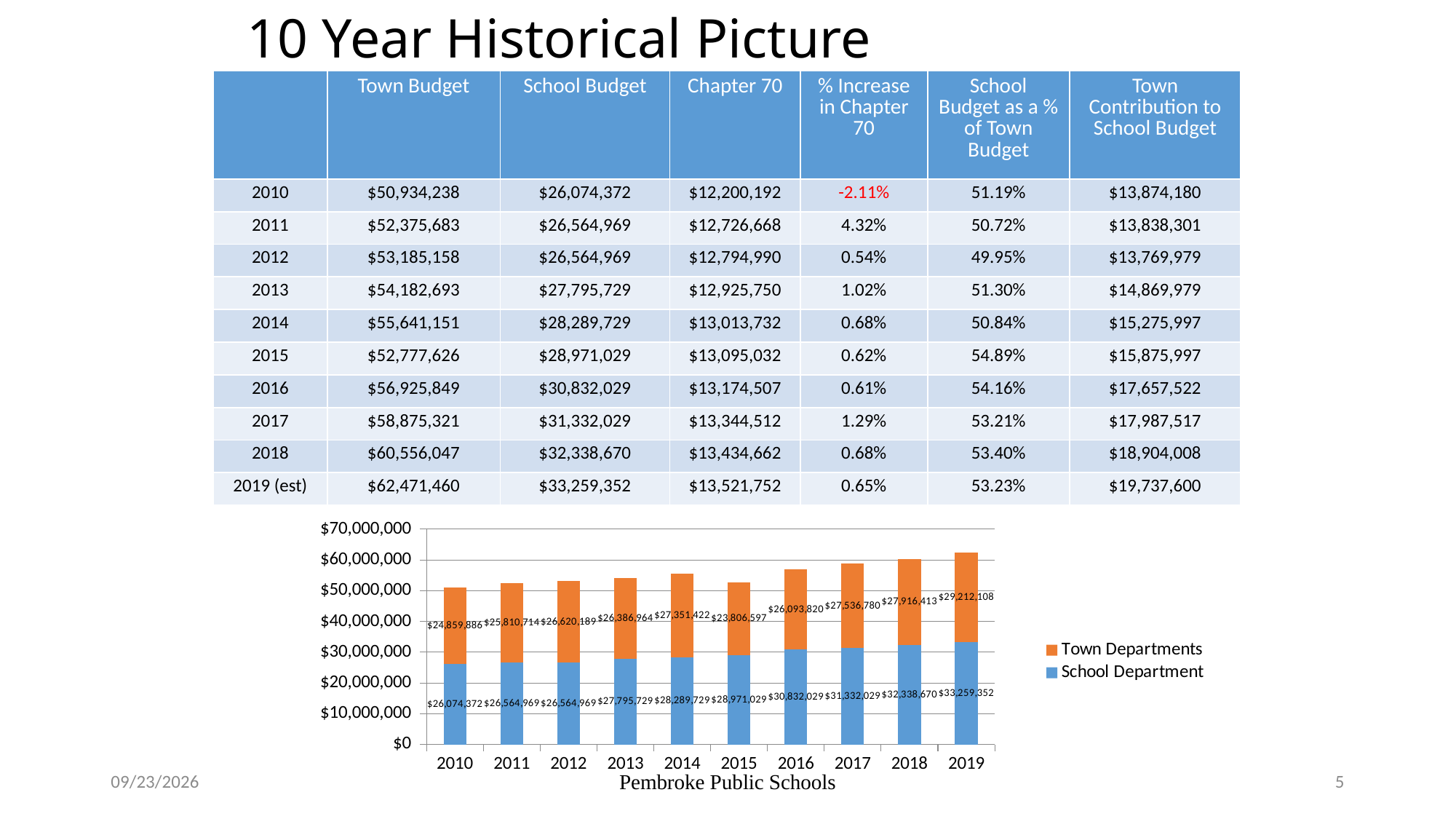
What type of chart is shown on the slide? Stacked bar chart Do the School Department values rise or fall from 2010 to 2019 in the chart? Rise What is the School Department value for 2019 in the chart? $33,259,352 How many years are plotted along the x axis of the chart? 10 In the chart, is the School Department value for 2019 larger than the Town Departments value for 2019? Yes How many series does the chart legend list? 2 What is the total of the stacked bar for 2019 in the chart? $62,471,460 Which year has the highest School Department value in the chart? 2019 What is the difference between the School Department value and the Town Departments value for 2019 in the chart? $4,047,244 Which year has the lowest Town Departments value in the chart? 2015 What is the Town Departments value for 2015 in the chart? $23,806,597 Is the total of the stacked bar for 2019 greater or less than $60,000,000? greater